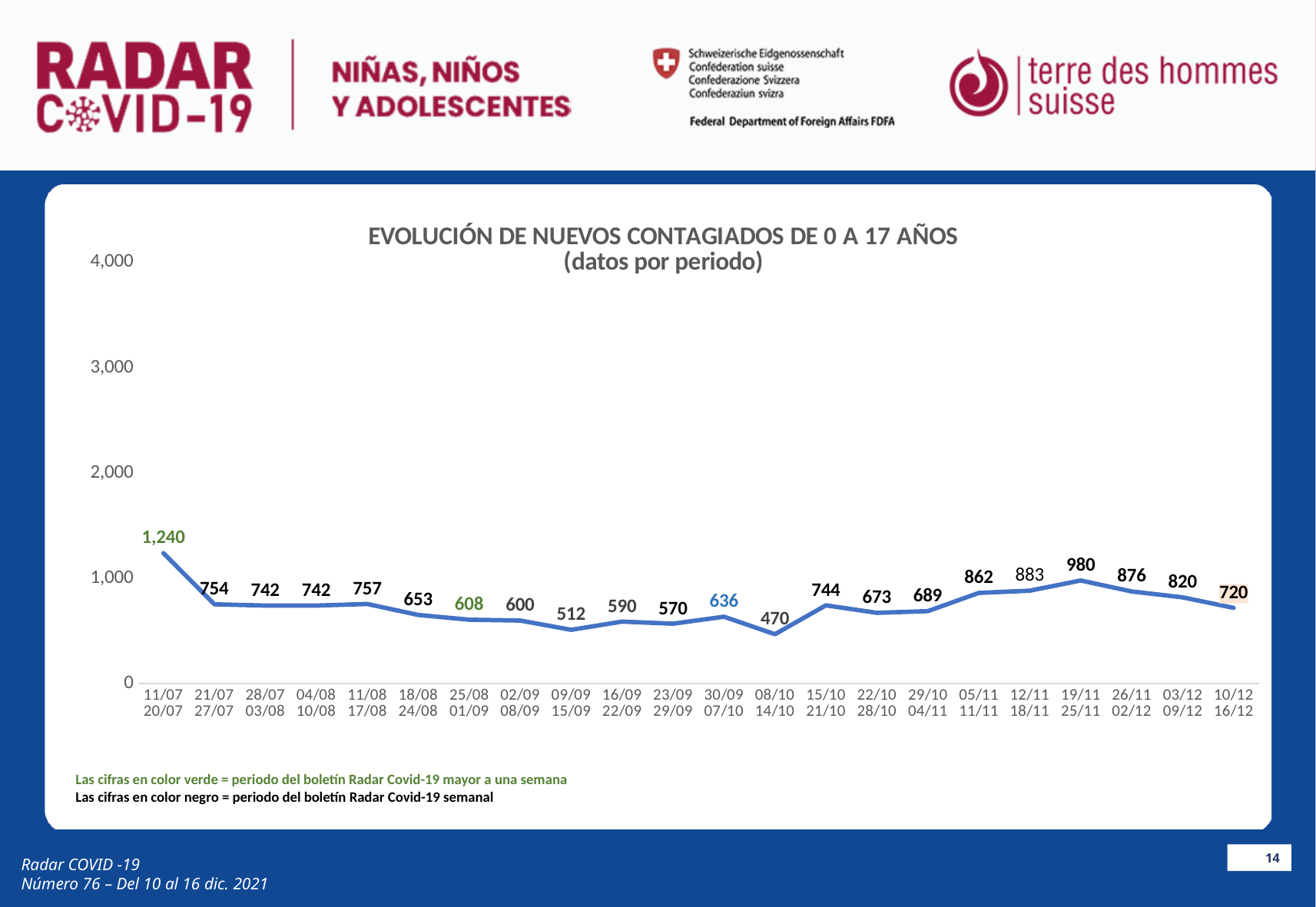
What is the value for the period 19/11–25/11? 980 What is the difference between the values for 19/11–25/11 and 10/12–16/12? 260 What is the value for the period 11/07–20/07? 1,240 Which period has the lowest value? 08/10–14/10 Is the value for 19/11–25/11 greater or less than 1,000? less Which period has the highest value? 11/07–20/07 How many periods are plotted on the chart? 22 What is the value for the period 08/10–14/10? 470 Which is larger, the value for 05/11–11/11 or the value for 12/11–18/11? 12/11–18/11 What is the value for the last period, 10/12–16/12? 720 What type of chart is shown on the slide? line chart What is the title of the chart? EVOLUCIÓN DE NUEVOS CONTAGIADOS DE 0 A 17 AÑOS (datos por periodo)